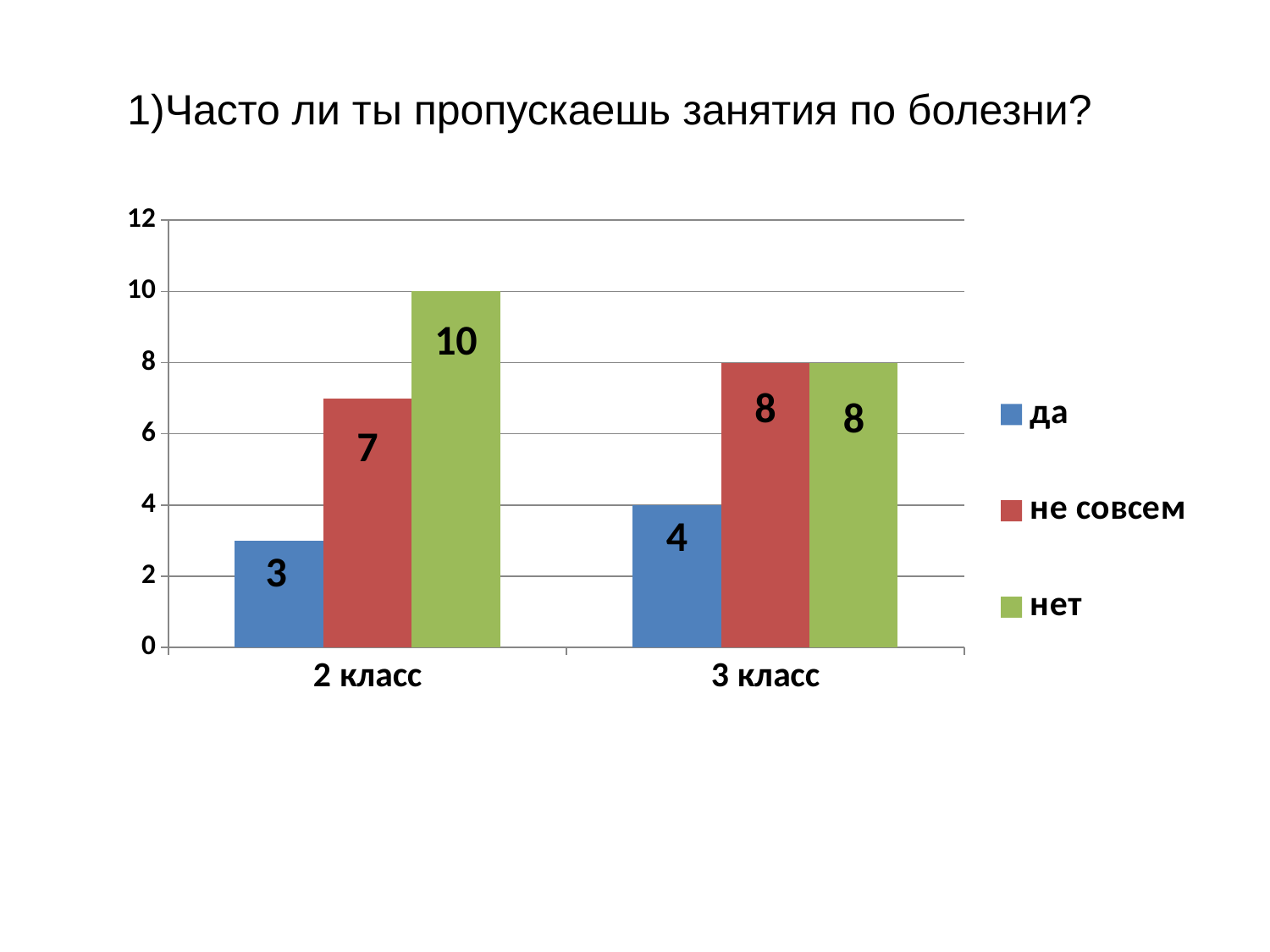
Which series has the lowest value in "3 класс"? да Which series has the highest value in "2 класс"? нет What kind of chart is shown on the slide? bar chart What is the value for "не совсем" in "3 класс"? 8 How many categories are shown on the x axis? 2 What is the value for "нет" in "2 класс"? 10 What is the value for "да" in "2 класс"? 3 What colour represents the "нет" series? green How many series does the legend list? 3 What is the value for "да" in "3 класс"? 4 Which is larger: "не совсем" in "2 класс" or "не совсем" in "3 класс"? не совсем in 3 класс What is the difference between "нет" and "да" in "2 класс"? 7